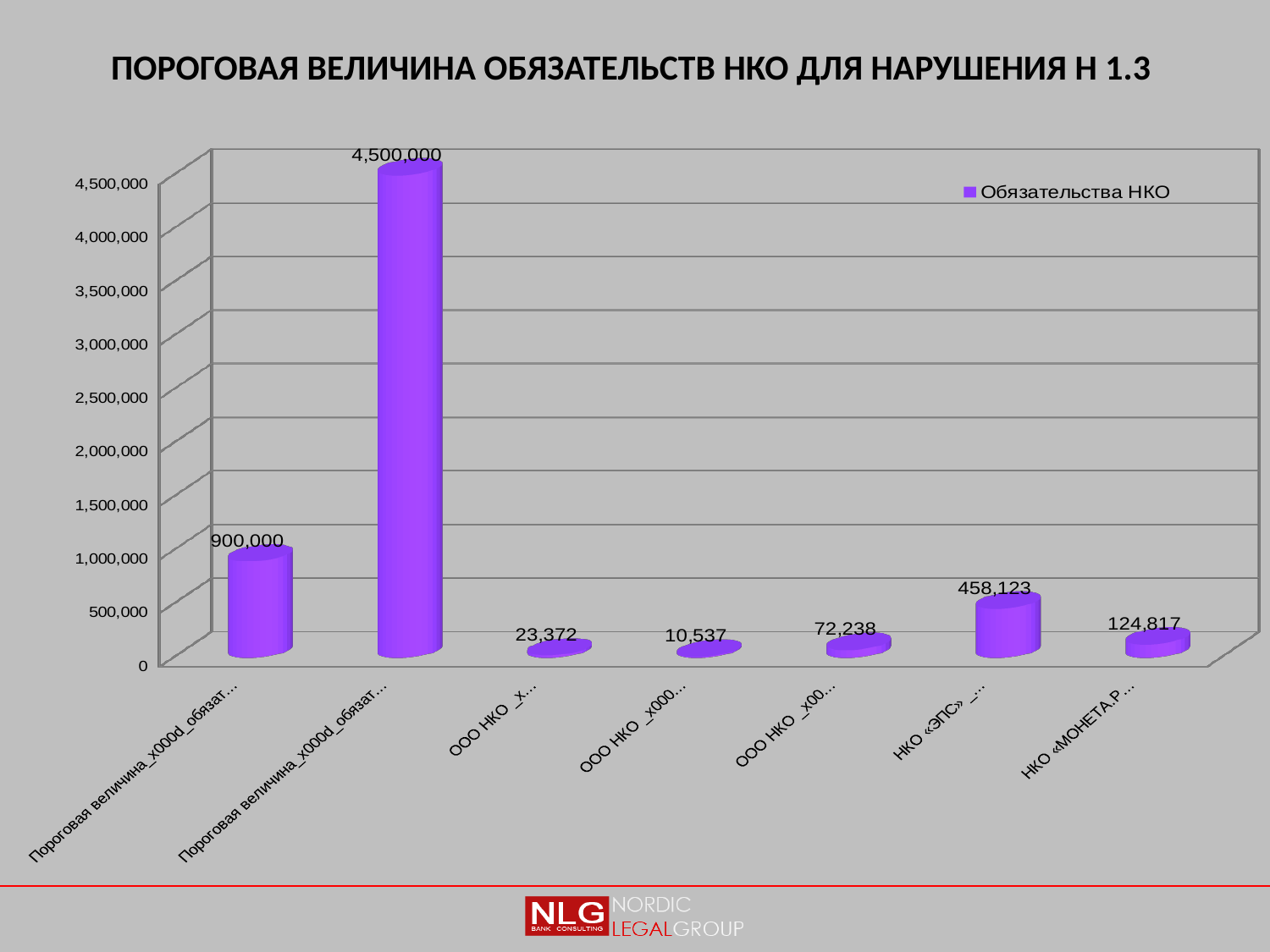
What is the value of the second bar from the left? 4,500,000 What is the value of the rightmost bar (НКО «МОНЕТА.Р...)? 124,817 How many series does the legend list? 1 What is the difference between the second bar (4,500,000) and the first bar (900,000)? 3,600,000 Which is larger: the value for НКО «ЭПС» or the value for the rightmost bar (НКО «МОНЕТА.Р...)? НКО «ЭПС» What is the name of the series shown in the legend? Обязательства НКО What is the value of the first bar from the left? 900,000 What is the value for the bar labelled НКО «ЭПС»? 458,123 Which bar has the highest value? the second bar from the left (4,500,000) What type of chart is shown on the slide? bar chart Which bar has the lowest value? the fourth bar from the left (10,537) How many bars (categories) are plotted in the chart? 7